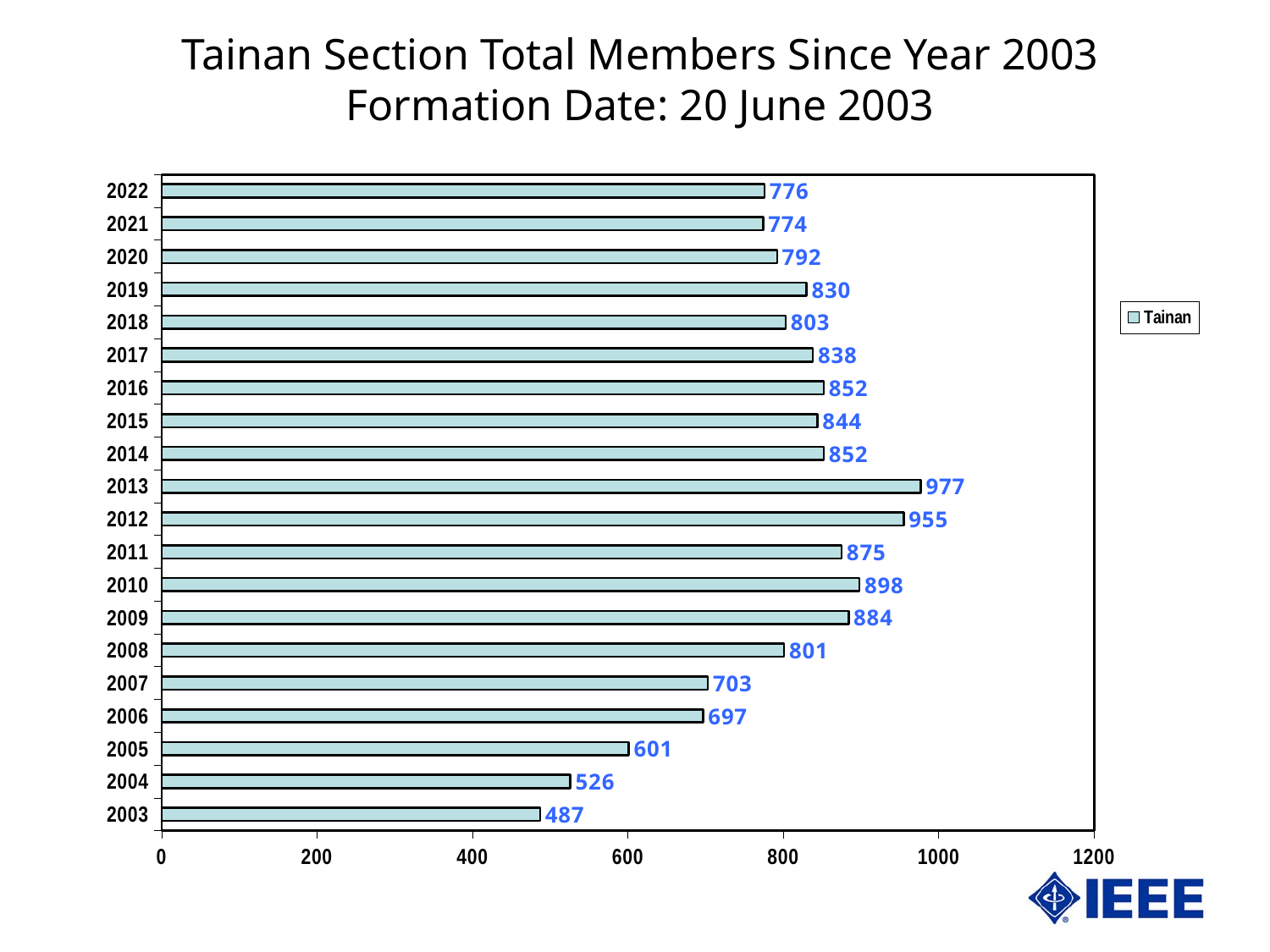
What kind of chart is shown? bar chart What is the difference between the values for 2013 and 2012? 22 What is the value for 2020? 792 Which year has the highest value? 2013 Which is larger, the value for 2010 or the value for 2011? 2010 Which year has the lowest value? 2003 How many series does the legend list? 1 How many years are shown on the chart? 20 What is the value for 2013? 977 What is the difference between the values for 2022 and 2003? 289 What is the value for 2003? 487 What series name is shown in the legend? Tainan